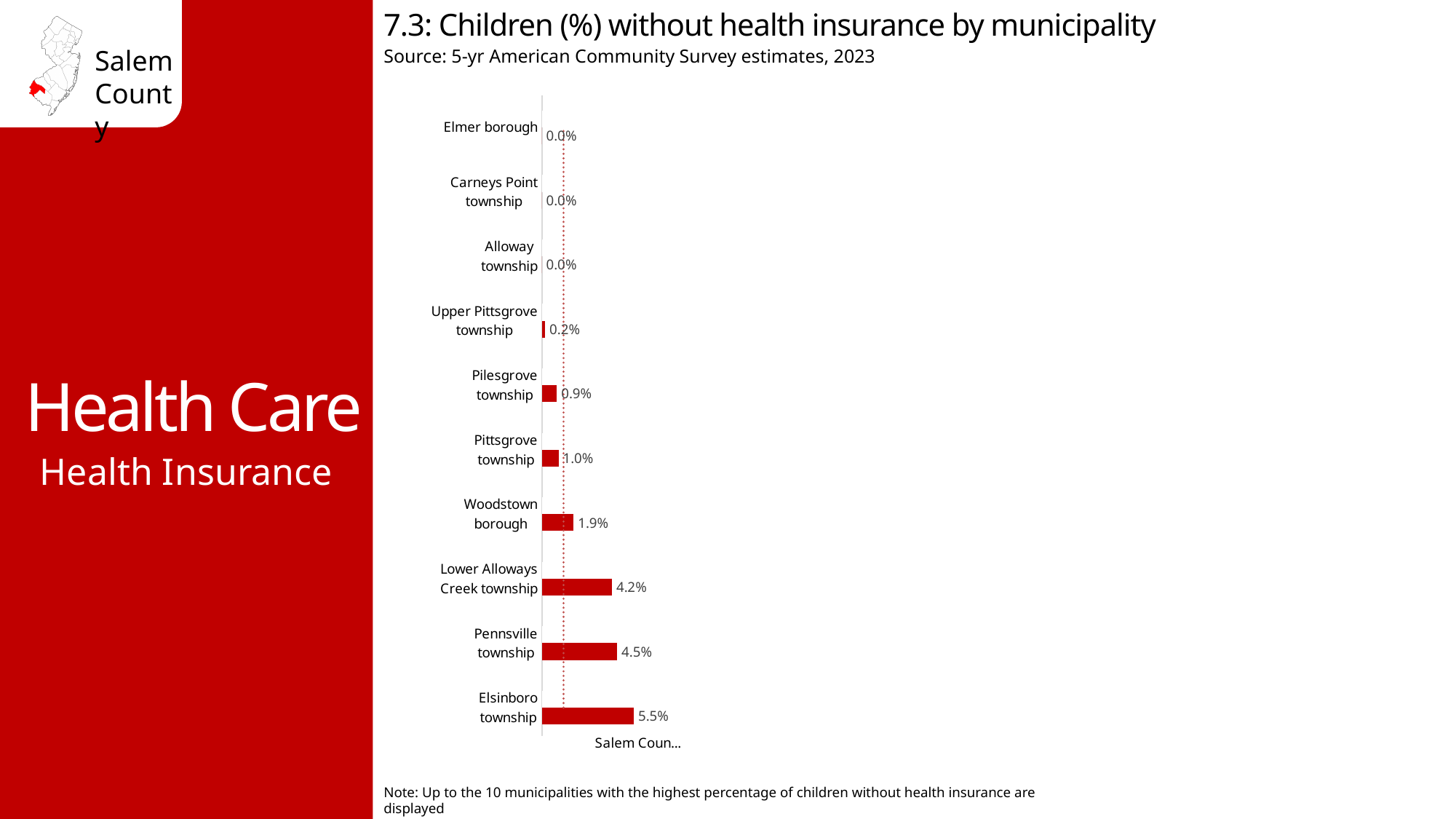
Which is larger, the value for Pittsgrove township or the value for Pilesgrove township? Pittsgrove township What percentage is shown for Lower Alloways Creek township? 4.2% Which municipality has the highest percentage of children without health insurance? Elsinboro township What is the difference between the values for Elsinboro township and Pennsville township? 1.0% What is the value shown for Upper Pittsgrove township? 0.2% What is the value shown for Pennsville township? 4.5% What percentage of children are without health insurance in Elsinboro township? 5.5% What is the value for Woodstown borough? 1.9% How many municipalities show a value of 0.0%? 3 How many municipalities are shown in the chart? 10 What is the difference between the values for Lower Alloways Creek township and Woodstown borough? 2.3% What kind of chart is shown on the slide? Bar chart